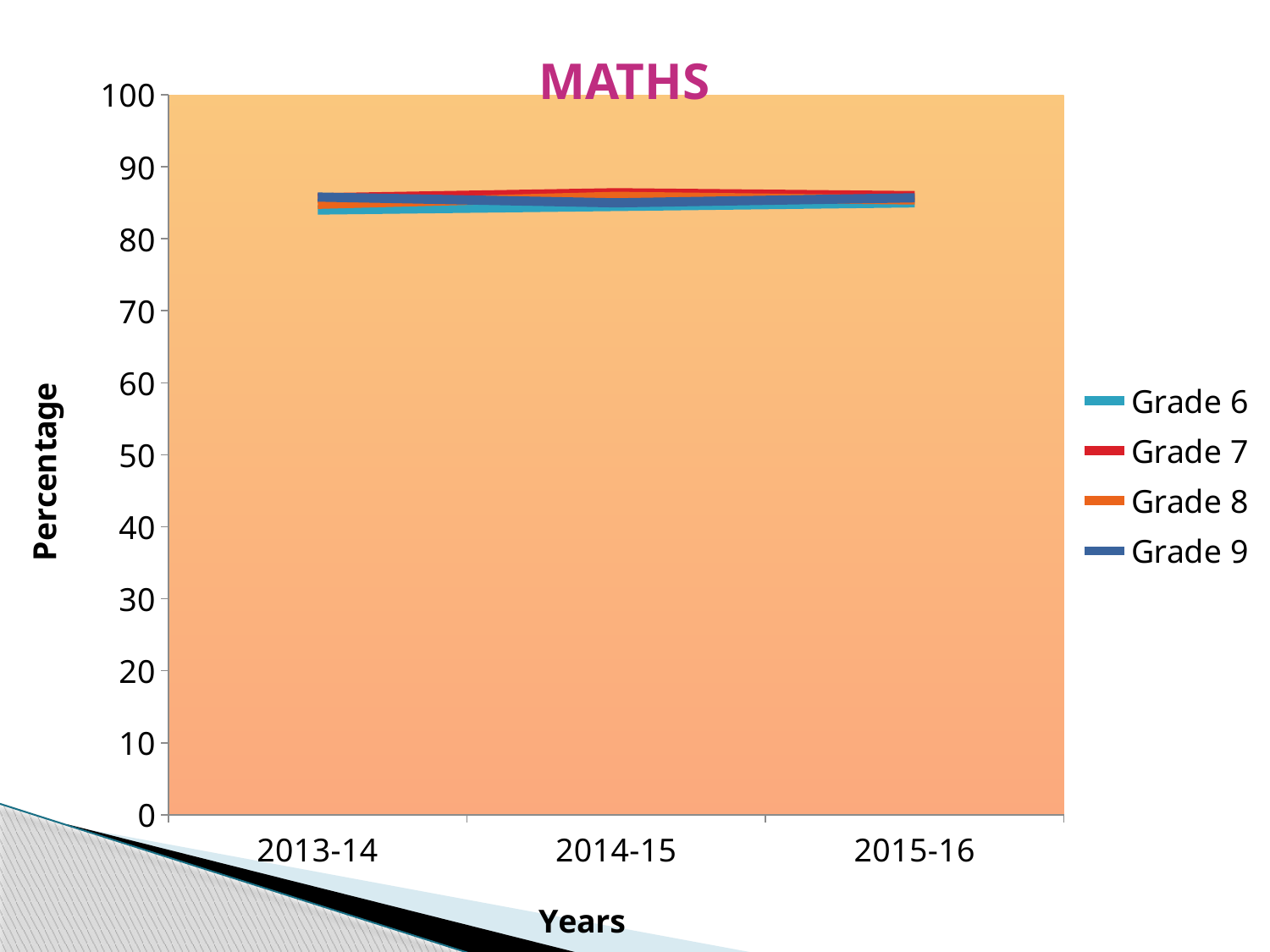
What type of chart is shown on the slide? line chart Is the value for Grade 6 in 2015-16 greater or less than 50? greater Which series is shown in red in the legend? Grade 7 Is the value for Grade 9 in 2015-16 greater or less than 70? greater Is the value for Grade 6 in 2013-14 greater or less than 80? greater What is the label of the y axis? Percentage What is the title of the chart? MATHS How many years are shown on the x axis? 3 How many series does the legend list? 4